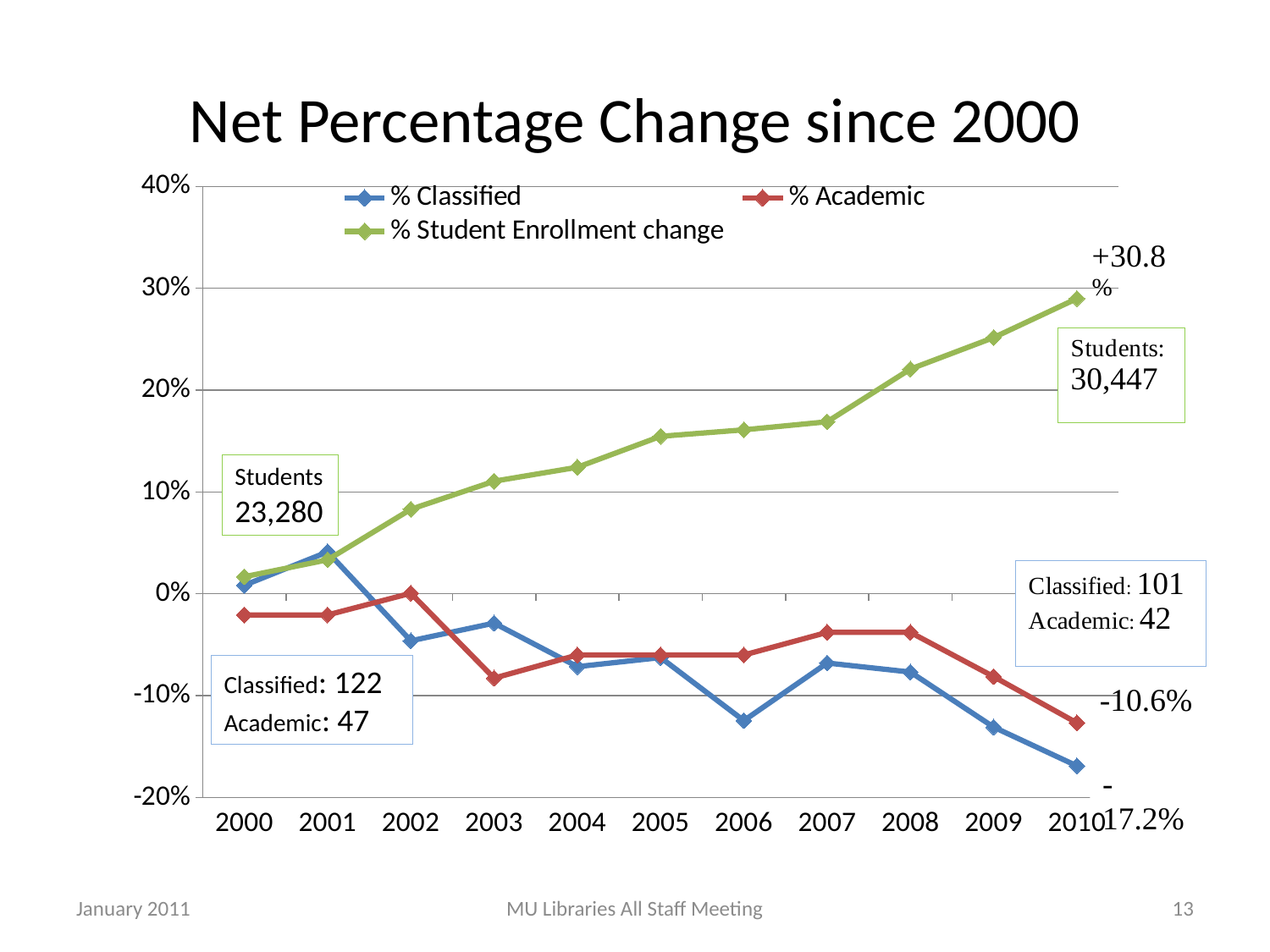
Is the value for % Academic in 2005 greater or less than 0%? less Does the % Classified series rise or fall overall from 2001 to 2010? fall Does the % Student Enrollment change series rise or fall from 2000 to 2010? rise Which series has the highest value in 2010? % Student Enrollment change What kind of chart is shown on the slide? line chart Which series has the lowest value in 2010? % Classified How many series does the legend list? 3 Is the value for % Student Enrollment change in 2005 greater or less than 10%? greater How many years are plotted along the x axis? 11 In 2006, which is higher: % Classified or % Academic? % Academic Is the value for % Student Enrollment change in 2010 greater or less than 20%? greater